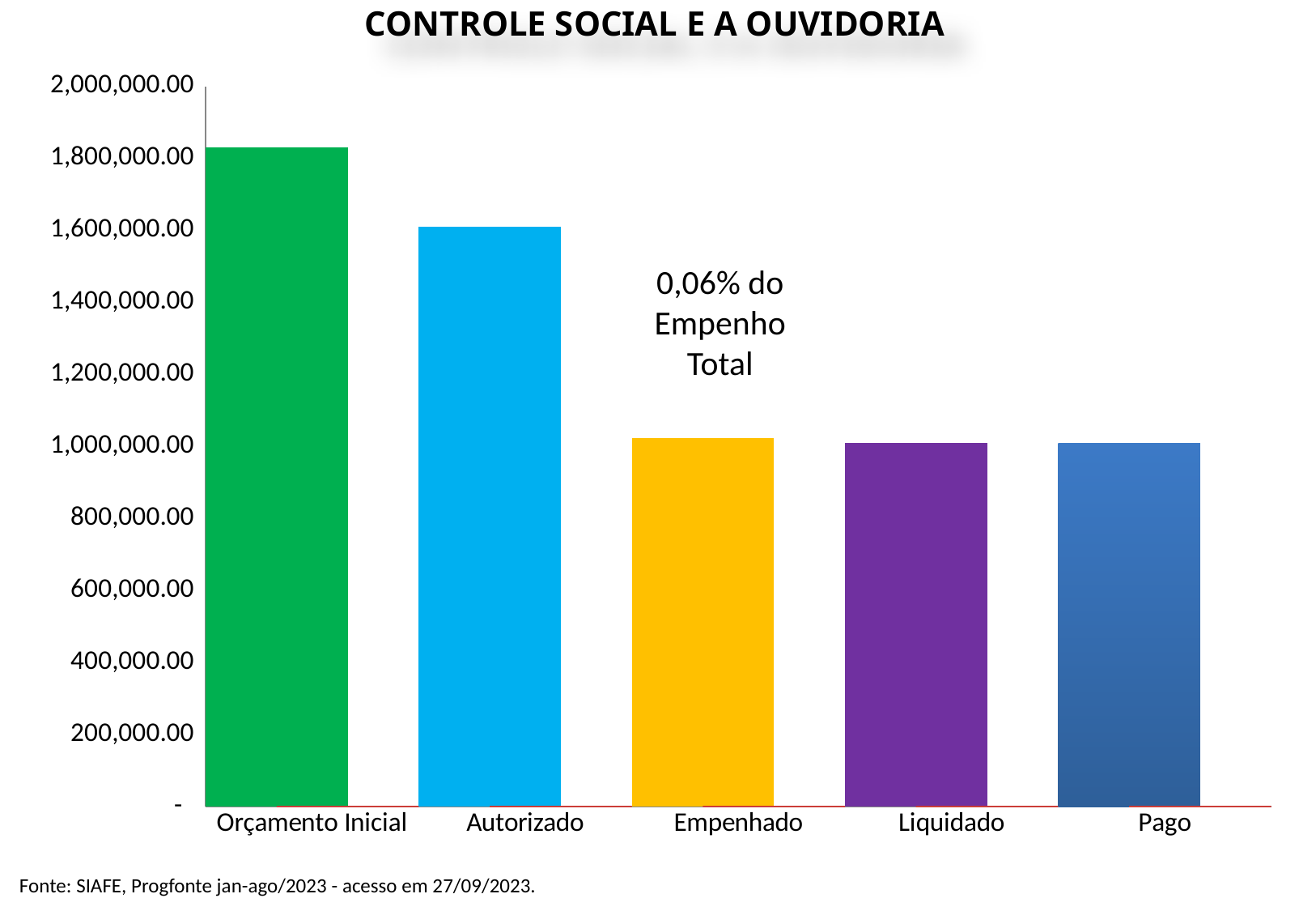
How many categories are plotted on the chart? 5 What is the title of the chart? CONTROLE SOCIAL E A OUVIDORIA What text annotation appears above the Empenhado bar? 0,06% do Empenho Total Is the value for Pago greater or less than 800,000.00? greater Is the value for Empenhado greater or less than 1,200,000.00? less What kind of chart is shown on the slide? Bar chart Which is larger, Orçamento Inicial or Autorizado? Orçamento Inicial Is the value for Autorizado greater or less than 1,800,000.00? less Which category has the highest value? Orçamento Inicial Do the values rise or fall from left to right across the categories? Fall Which is larger, Autorizado or Empenhado? Autorizado